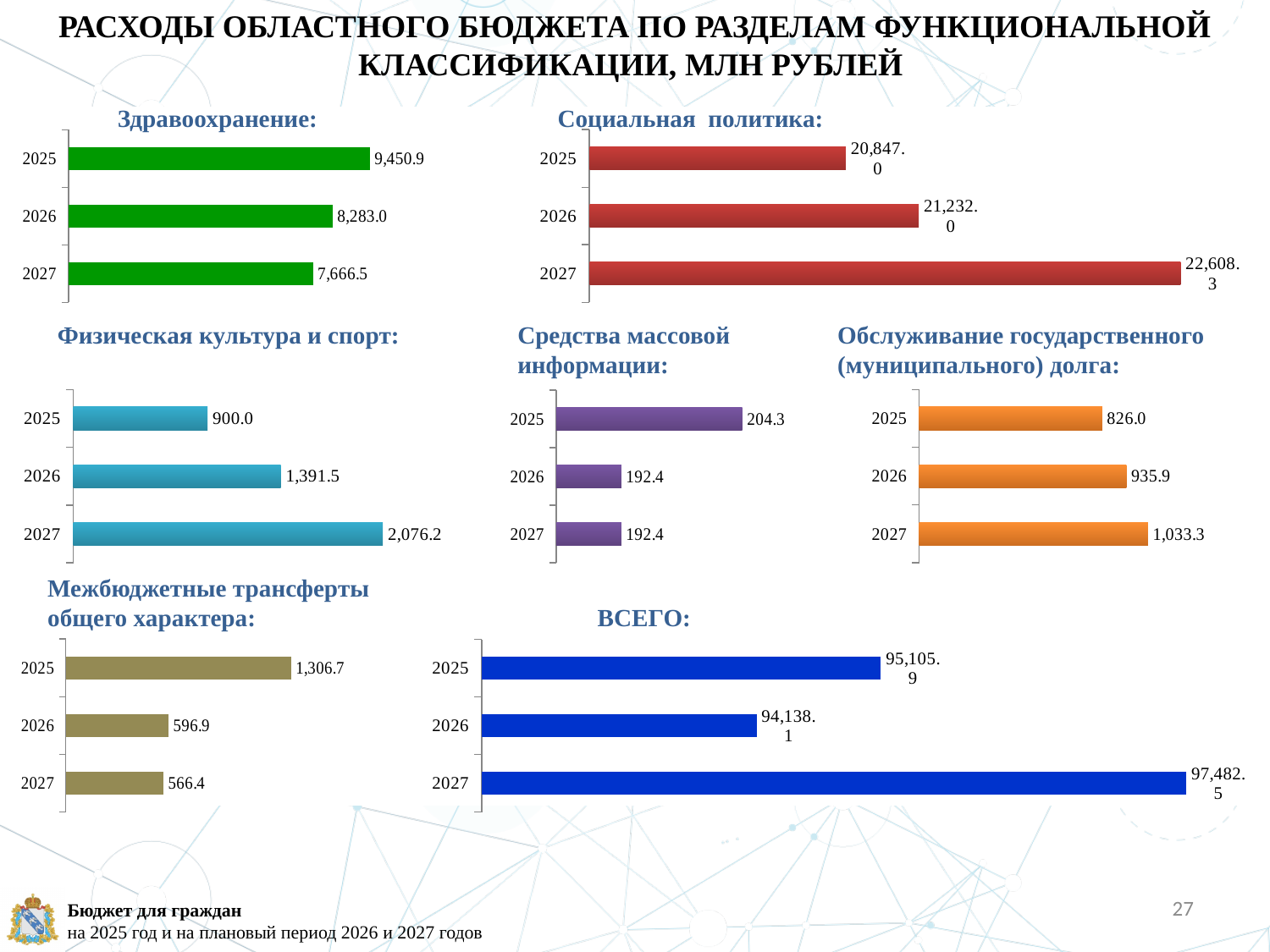
In the 'Здравоохранение' chart, what is the value for 2025? 9,450.9 In the 'ВСЕГО' chart, what is the value for 2026? 94,138.1 In the 'Физическая культура и спорт' chart, what is the difference between the 2027 and 2025 values? 1,176.2 In the 'Обслуживание государственного (муниципального) долга' chart, what is the value for 2026? 935.9 What type of chart is the 'ВСЕГО' chart? bar chart In the 'Средства массовой информации' chart, which year has the highest value? 2025 In the 'Здравоохранение' chart, which year has the lowest value? 2027 In the 'Межбюджетные трансферты общего характера' chart, which is larger, the value for 2025 or for 2027? 2025 In the 'Социальная политика' chart, what is the value for 2027? 22,608.3 In the 'Социальная политика' chart, do the values rise or fall from 2025 to 2027? rise In the 'ВСЕГО' chart, which year has the highest value? 2027 How many charts are shown on the slide? 7